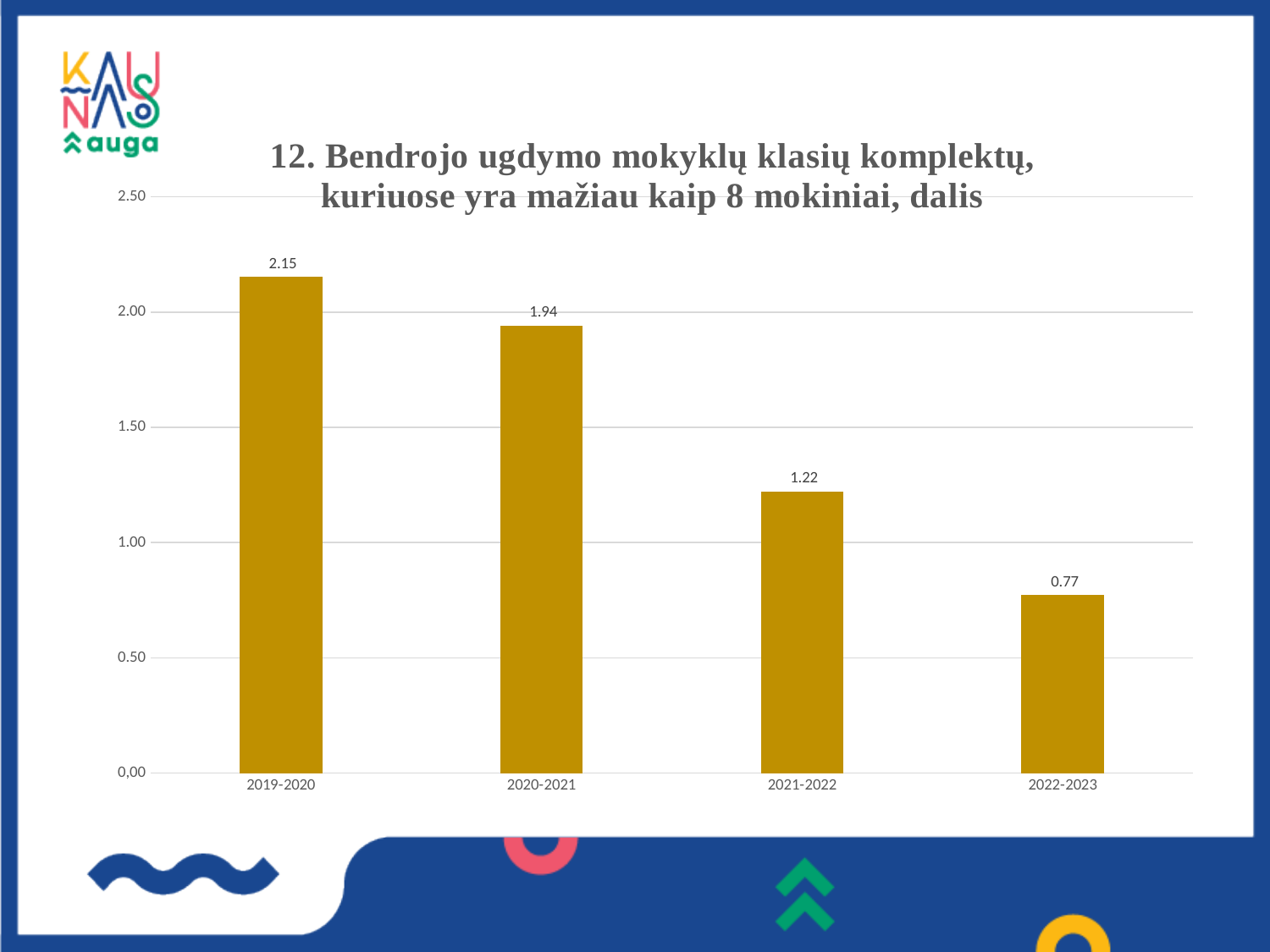
What kind of chart is shown on the slide? Bar chart What is the difference between the values for 2020-2021 and 2021-2022? 0.72 What is the value for 2020-2021? 1.94 Do the values rise or fall from 2019-2020 to 2022-2023? Fall Which school year has the highest value? 2019-2020 What is the value for 2022-2023? 0.77 What is the difference between the values for 2019-2020 and 2022-2023? 1.38 What is the value for 2019-2020? 2.15 Which is larger, the value for 2020-2021 or the value for 2021-2022? 2020-2021 How many school years are shown on the chart? 4 Which school year has the lowest value? 2022-2023 What is the value for 2021-2022? 1.22